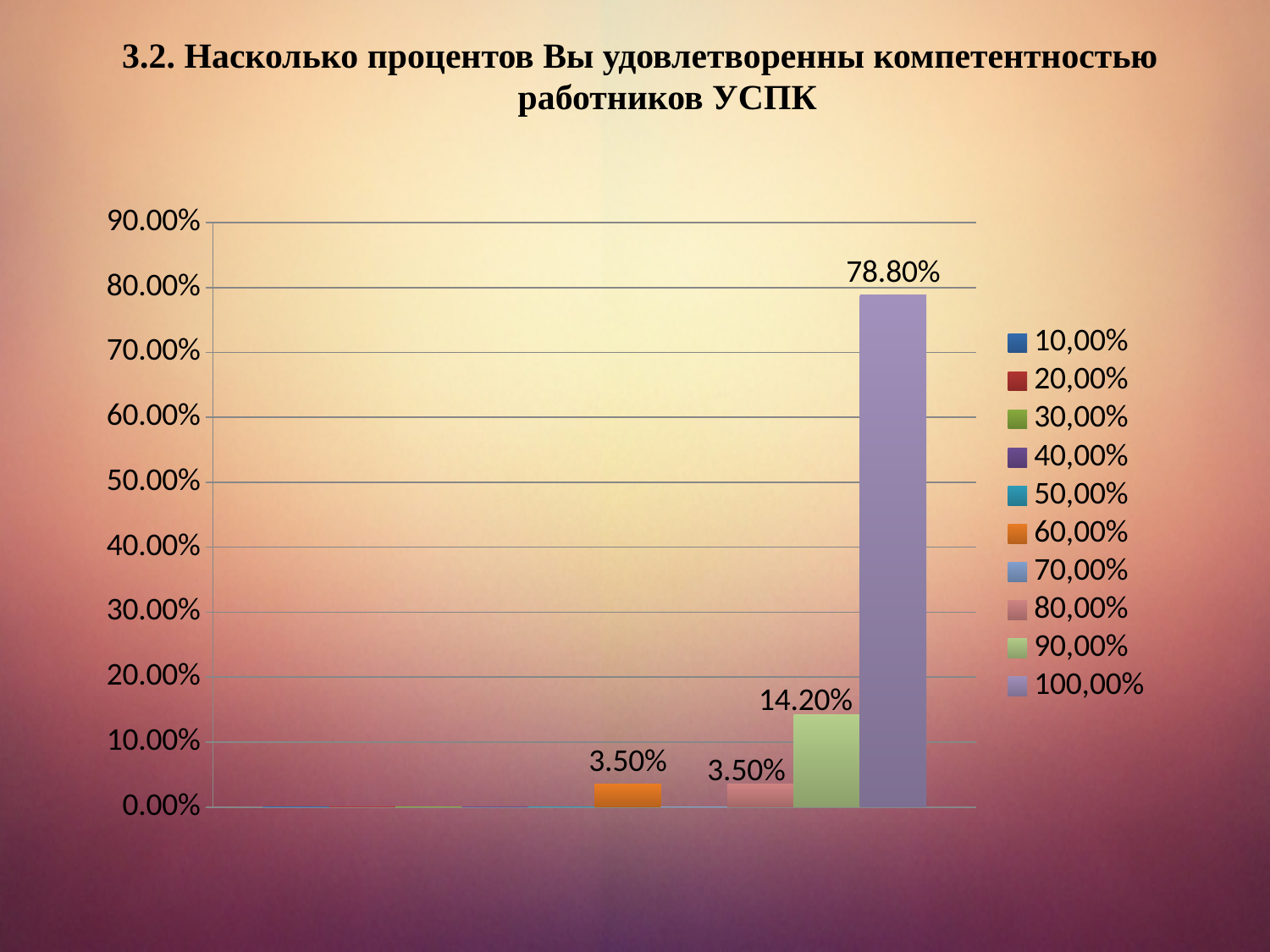
Which is larger, the value for the 90,00% series or the 80,00% series? 90,00% What kind of chart is shown on the slide? bar chart What value is shown for the 60,00% series? 3.50% How many series does the legend list? 10 What value is shown for the 90,00% series? 14.20% What value is shown for the 100,00% series? 78.80% What value is shown for the 80,00% series? 3.50% What colour is the bar for the 100,00% series? purple What is the difference between the values for the 100,00% and 90,00% series? 64.60% Which series has the highest value? 100,00% Is the value for the 100,00% series greater or less than 70.00%? greater What is the difference between the values for the 90,00% and 60,00% series? 10.70%